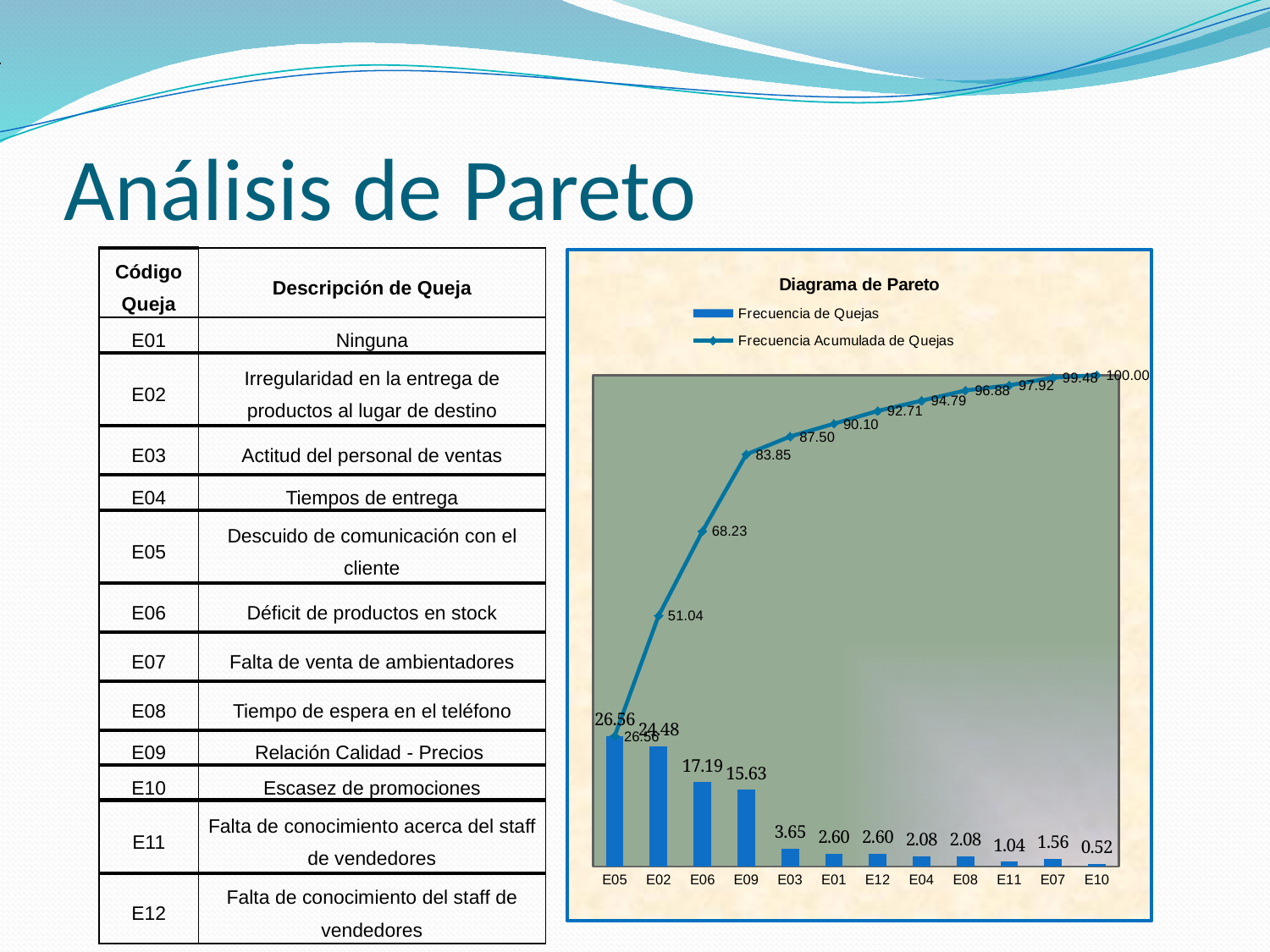
How many categories are shown on the x axis of the chart? 12 What is the title of the chart on the slide? Diagrama de Pareto Which has the larger Frecuencia de Quejas value, E07 or E11? E07 What is the difference between the Frecuencia de Quejas values for E05 and E02? 2.08 What is the Frecuencia de Quejas value for E05? 26.56 How many series does the chart's legend list? 2 What is the Frecuencia Acumulada de Quejas value at E09? 83.85 Does the Frecuencia Acumulada de Quejas line rise or fall from E05 to E10? rise What is the Frecuencia Acumulada de Quejas value at E06? 68.23 What is the Frecuencia de Quejas value for E03? 3.65 Which category has the lowest Frecuencia de Quejas bar? E10 Which category has the highest Frecuencia de Quejas bar? E05